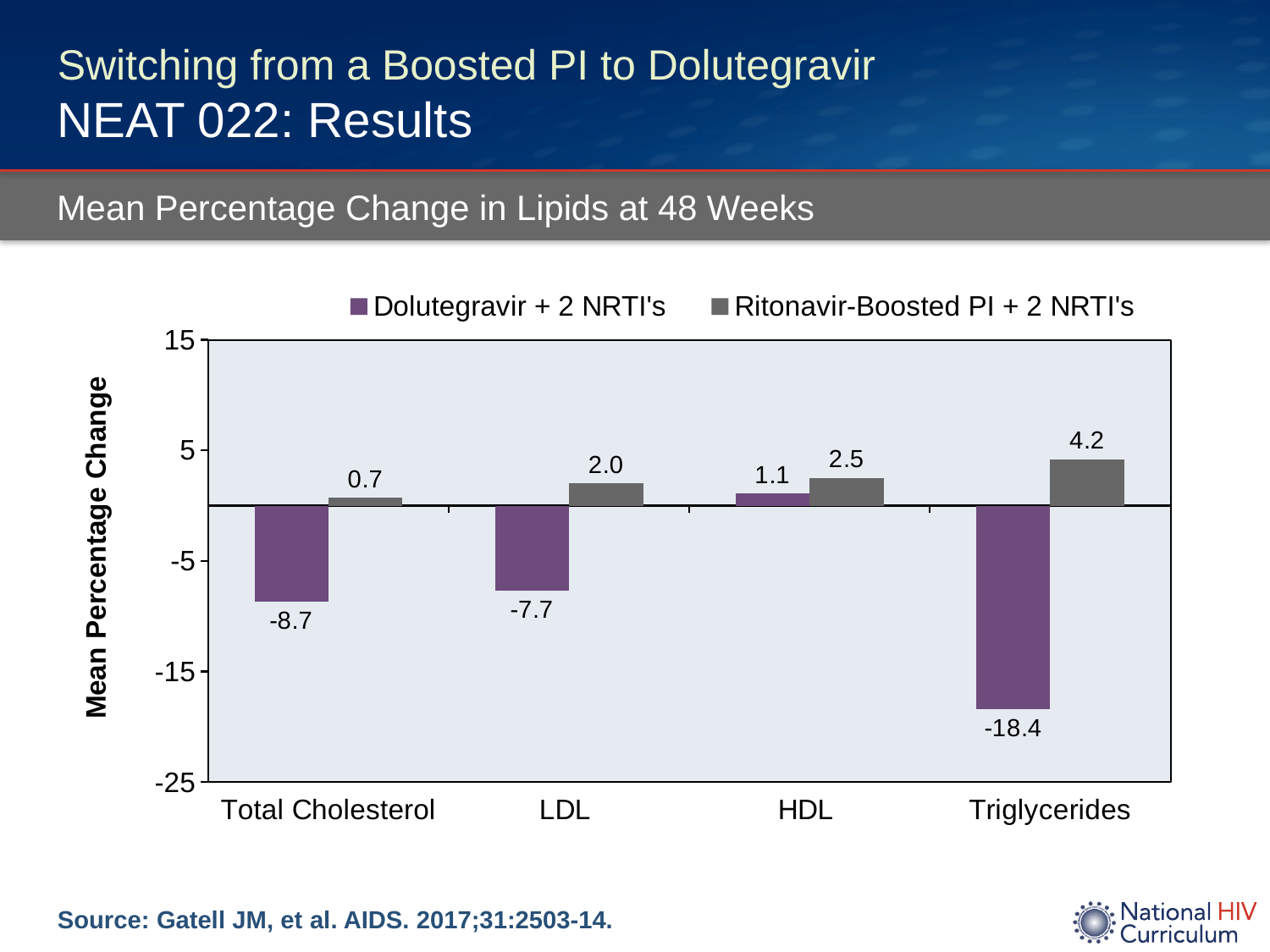
Which lipid category has the highest value for Ritonavir-Boosted PI + 2 NRTI's? Triglycerides What is the mean percentage change in total cholesterol for Dolutegravir + 2 NRTI's? -8.7 How many series does the legend list? 2 What is the mean percentage change in triglycerides for Ritonavir-Boosted PI + 2 NRTI's? 4.2 What is the label of the y axis? Mean Percentage Change Which lipid category has the lowest value for Dolutegravir + 2 NRTI's? Triglycerides What kind of chart is shown on the slide? Bar chart What is the mean percentage change in LDL for Ritonavir-Boosted PI + 2 NRTI's? 2.0 How many lipid categories are shown on the x axis? 4 For HDL, which series has the larger value, Dolutegravir + 2 NRTI's or Ritonavir-Boosted PI + 2 NRTI's? Ritonavir-Boosted PI + 2 NRTI's What is the difference between the Ritonavir-Boosted PI + 2 NRTI's and Dolutegravir + 2 NRTI's values for triglycerides? 22.6 What is the mean percentage change in HDL for Dolutegravir + 2 NRTI's? 1.1